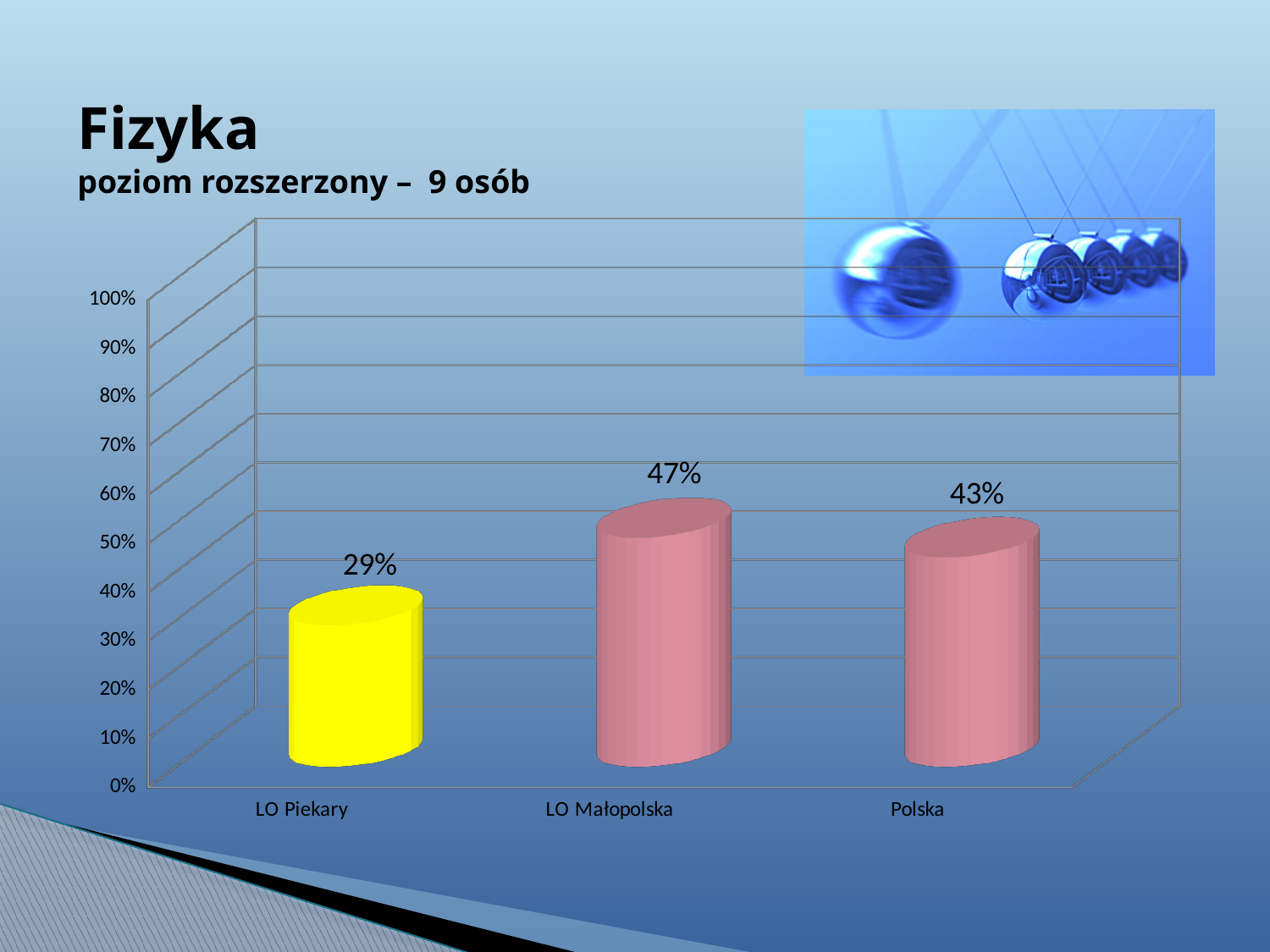
Which is larger, the value for LO Małopolska or the value for Polska? LO Małopolska What kind of chart is shown on the slide? bar chart What is the value for LO Małopolska? 47% What is the difference between the values for Polska and LO Piekary? 14% Is the value for LO Piekary greater or less than 50%? less How many categories are shown on the chart? 3 What is the difference between the values for LO Małopolska and LO Piekary? 18% What is the value for Polska? 43% What is the value for LO Piekary? 29% Which category has the lowest value? LO Piekary Which category has the highest value? LO Małopolska What colour is the bar for LO Piekary? yellow